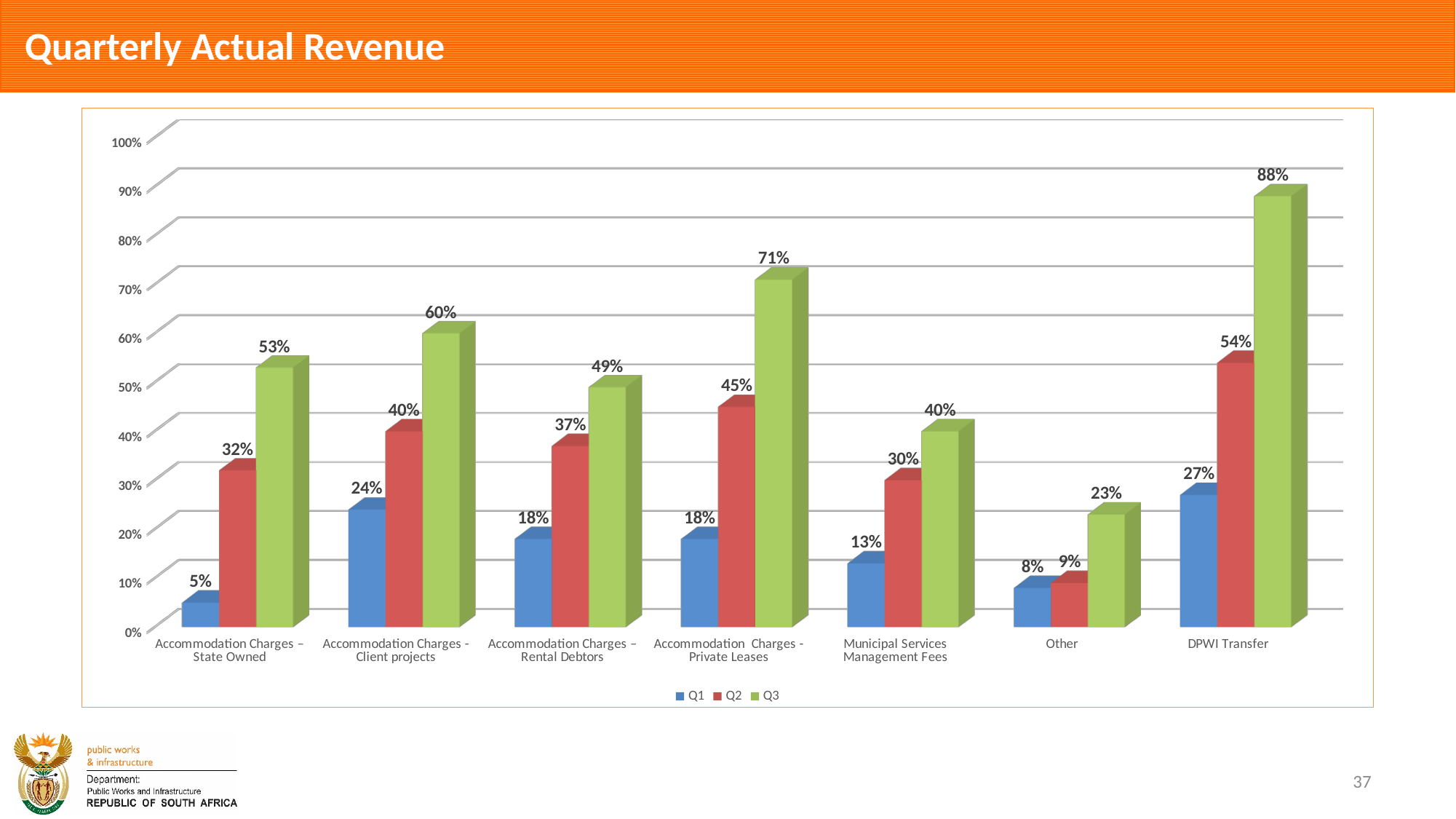
How many series does the legend list? 3 What is the Q1 value for Accommodation Charges – State Owned? 5% How many categories are shown on the x axis? 7 Which category has the lowest Q1 value? Accommodation Charges – State Owned What kind of chart is shown on the slide? Bar chart Which is larger, the Q2 value for Accommodation Charges - Client projects or the Q2 value for Accommodation Charges – Rental Debtors? Accommodation Charges - Client projects Which category has the highest Q3 value? DPWI Transfer What is the Q3 value for DPWI Transfer? 88% What is the title of the slide? Quarterly Actual Revenue What is the difference between the Q3 and Q1 values for Accommodation Charges - Private Leases? 53% Do the values for Other rise or fall from Q1 to Q3? Rise What is the Q2 value for Municipal Services Management Fees? 30%